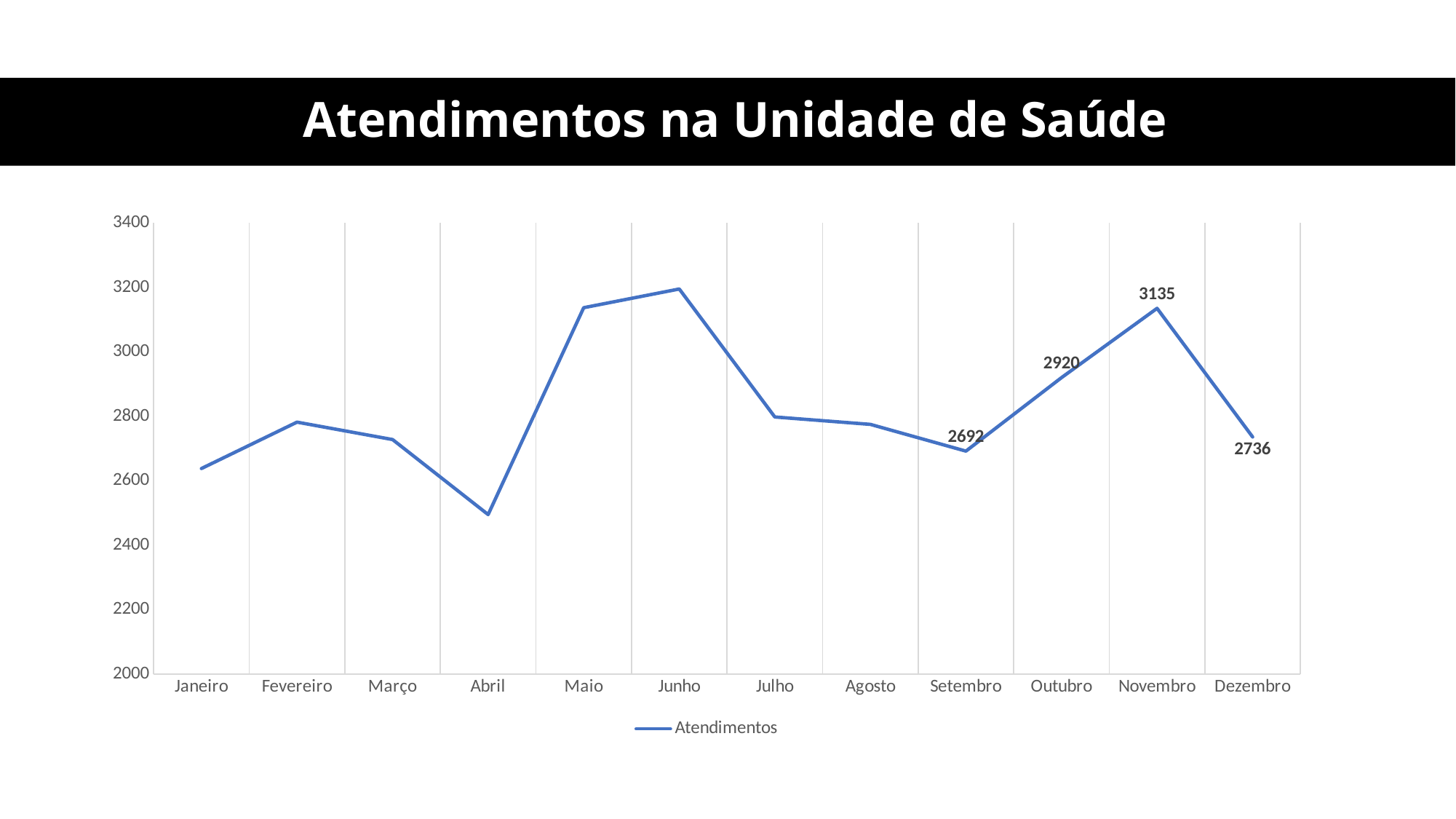
What is the value for Dezembro? 2736 Which month has the lowest value? Abril Which is larger, the value for Outubro or the value for Setembro? Outubro What is the difference between the values for Novembro and Dezembro? 399 Do the values rise or fall from Setembro to Novembro? Rise What type of chart is shown on the slide? Line chart How many months are plotted on the x axis? 12 Is the value for Abril greater or less than 2600? less Is the value for Maio greater or less than 3000? greater What is the difference between the values for Novembro and Outubro? 215 What is the value for Novembro? 3135 What is the value for Setembro? 2692